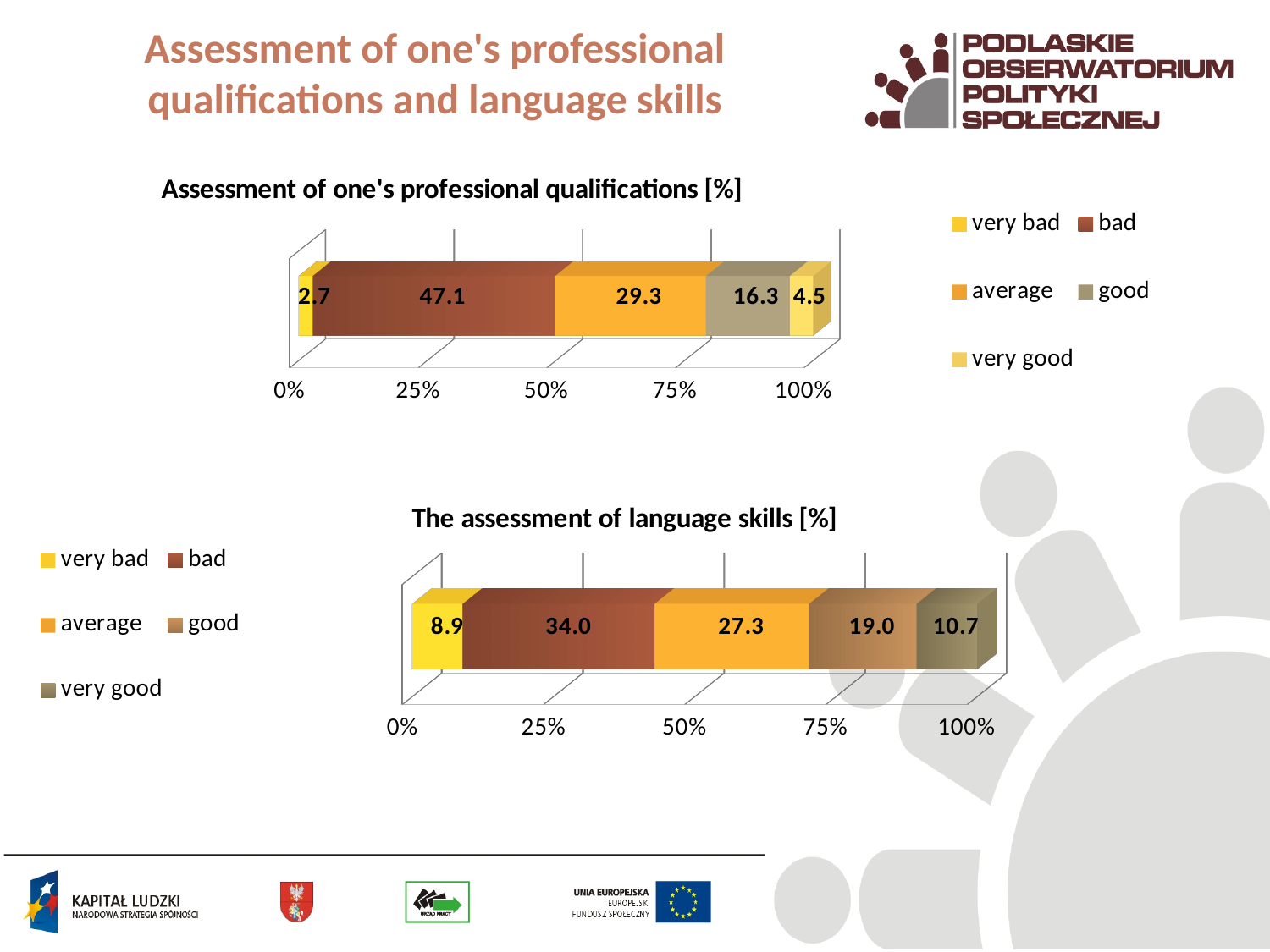
In the 'Assessment of one's professional qualifications [%]' chart, what is the value for 'bad'? 47.1 In 'The assessment of language skills [%]' chart, what is the value for 'very good'? 10.7 Which is larger: the 'very bad' value in the professional qualifications chart or the 'very bad' value in the language skills chart? language skills chart In the 'Assessment of one's professional qualifications [%]' chart, which category has the highest value? bad In 'The assessment of language skills [%]' chart, what is the value for 'average'? 27.3 What kind of chart is the 'Assessment of one's professional qualifications [%]' chart? stacked bar chart In the 'Assessment of one's professional qualifications [%]' chart, which category has the lowest value? very bad In the 'Assessment of one's professional qualifications [%]' chart, what is the value for 'good'? 16.3 In 'The assessment of language skills [%]' chart, which category has the lowest value? very bad In 'The assessment of language skills [%]' chart, what is the difference between the values for 'bad' and 'average'? 6.7 In the 'Assessment of one's professional qualifications [%]' chart, what is the total of the stacked bar? 99.9 How many series does the legend of 'The assessment of language skills [%]' chart list? 5